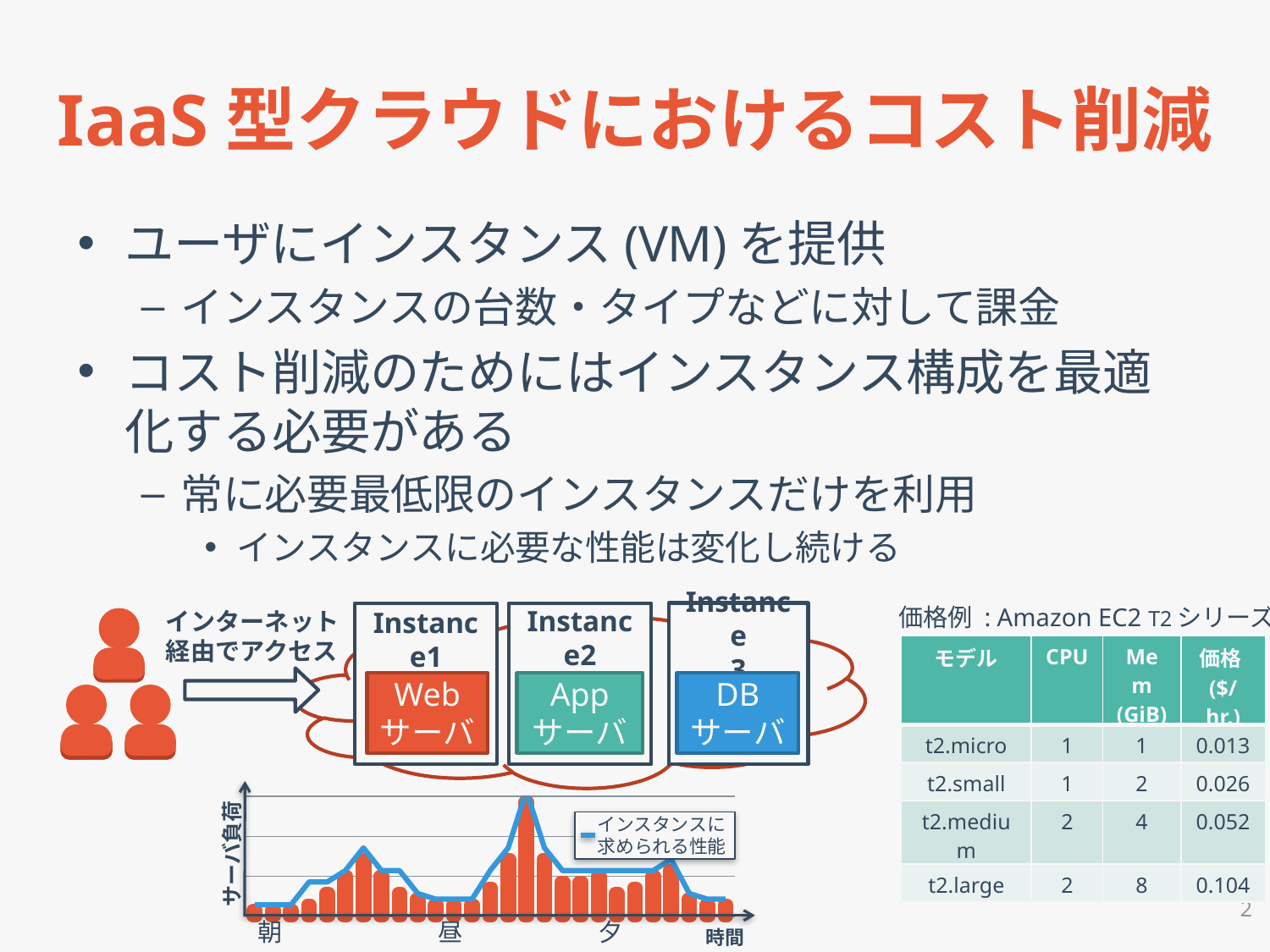
In the bottom chart, does the server load stay constant or rise and fall over the course of the day? rise and fall How many entries does the legend of the bottom chart list? 1 How many time labels are shown along the x axis of the bottom chart? 3 What kind of chart is shown at the bottom of the slide? bar chart with a line overlay What is the label of the vertical axis of the bottom chart? サーバ負荷 In the bottom chart, is the server load at 朝 (morning) higher or lower than the peak that occurs after 昼 (noon)? lower What is the legend entry of the bottom chart? インスタンスに求められる性能